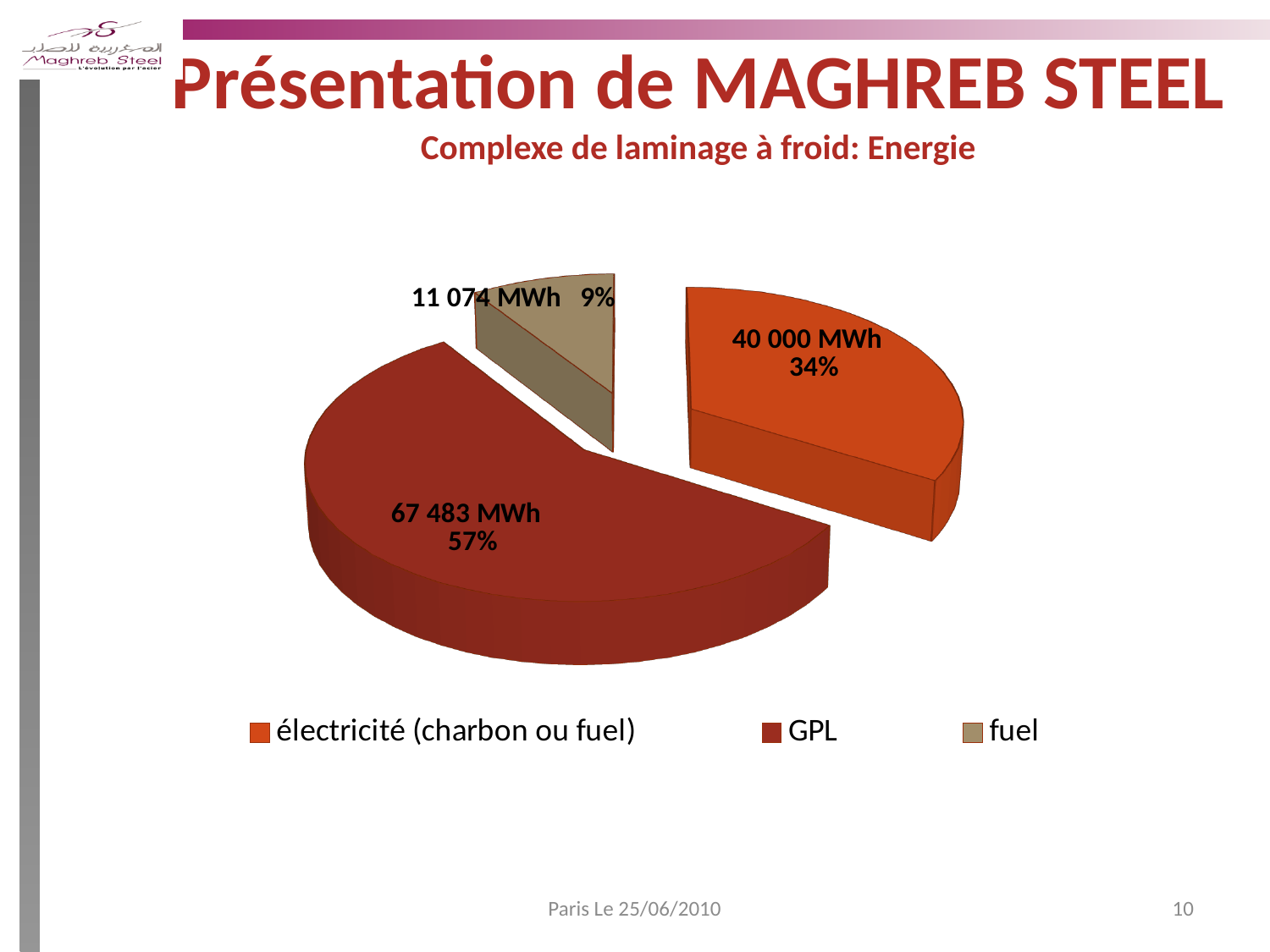
What is the difference between the value for GPL and the value for électricité (charbon ou fuel)? 27 483 MWh What share of the pie does GPL represent? 57% What share of the pie does électricité (charbon ou fuel) represent? 34% Which category has the smallest slice? fuel What is the value for électricité (charbon ou fuel)? 40 000 MWh What share of the pie does fuel represent? 9% Which category has the largest slice? GPL What is the value for fuel? 11 074 MWh What kind of chart is shown on the slide? pie chart Which is larger, the value for GPL or the value for électricité (charbon ou fuel)? GPL What is the value for GPL? 67 483 MWh How many slices does the pie chart have? 3